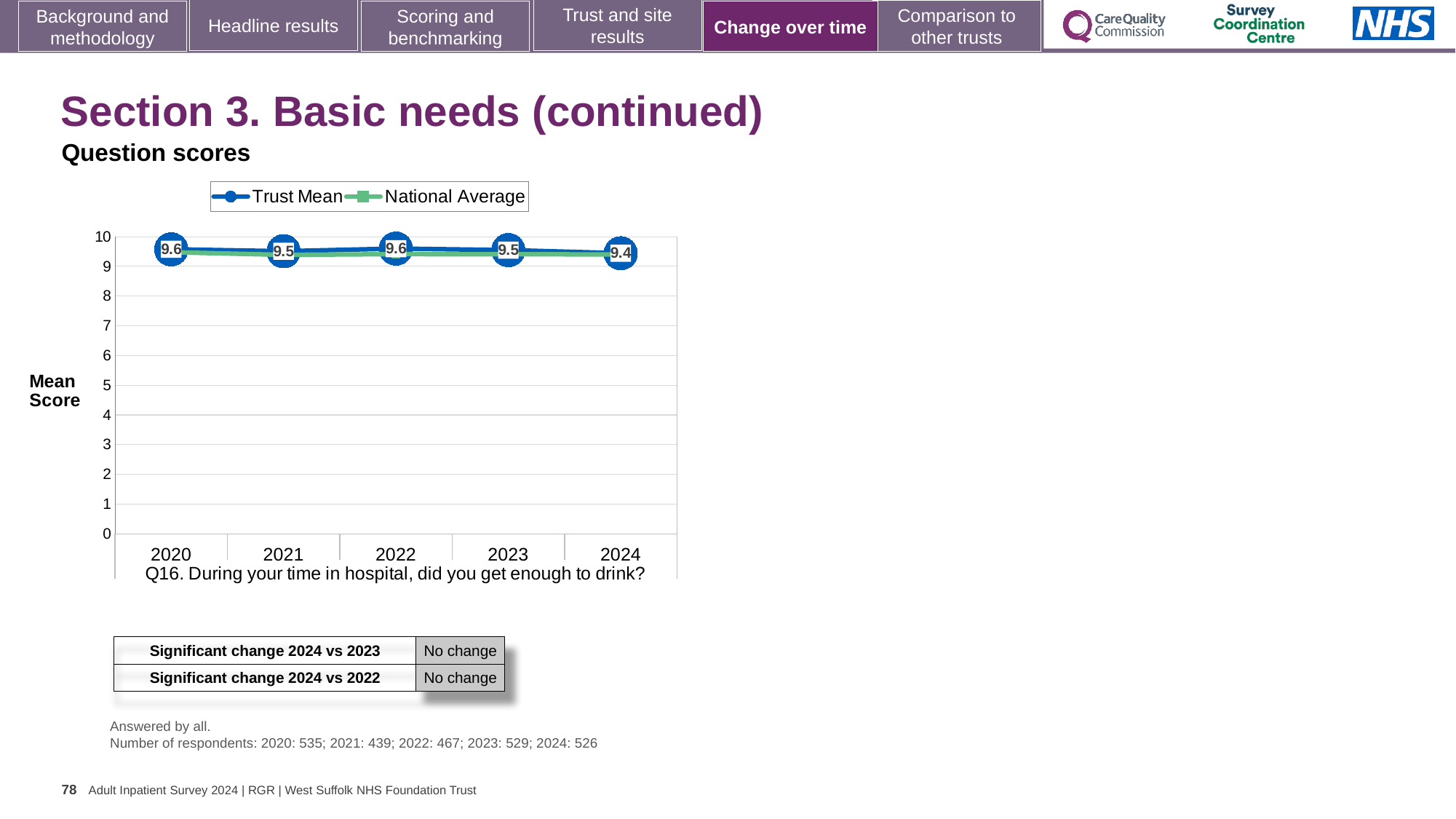
What is the Trust Mean score for 2020? 9.6 Is the National Average value for 2021 greater or less than 9? greater What is the Trust Mean score for 2024? 9.4 How many series does the legend list? 2 What is the difference between the Trust Mean score in 2020 and in 2024? 0.2 What kind of chart is shown? Line chart Which year has the larger Trust Mean score, 2020 or 2024? 2020 How many years are plotted on the x axis? 5 Does the Trust Mean score rise or fall from 2020 to 2024? Fall What is the Trust Mean score for 2022? 9.6 In which year is the Trust Mean score lowest? 2024 What is the Trust Mean score for 2021? 9.5